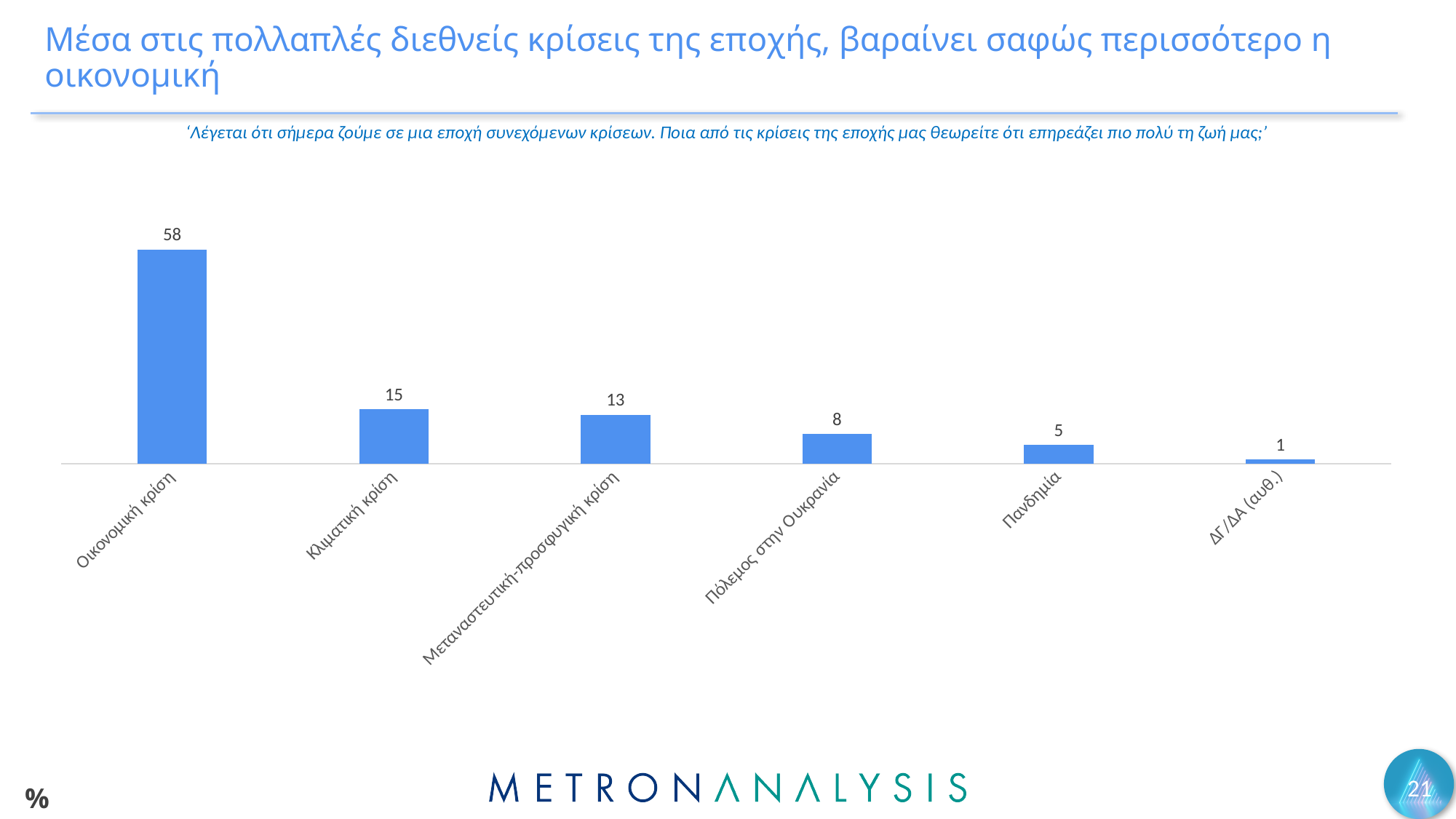
What is the value for Πανδημία? 5 What is the value for Κλιματική κρίση? 15 What kind of chart is shown on the slide? Bar chart Do the values rise or fall from left to right along the x axis? Fall What is the value for Οικονομική κρίση? 58 Which category has the lowest value? ΔΓ/ΔΑ (αυθ.) How many categories are shown in the chart? 6 What is the difference between the values for Οικονομική κρίση and Κλιματική κρίση? 43 What is the value for Μεταναστευτική-προσφυγική κρίση? 13 What is the value for Πόλεμος στην Ουκρανία? 8 Which is larger, the value for Πόλεμος στην Ουκρανία or the value for Πανδημία? Πόλεμος στην Ουκρανία Which category has the highest value? Οικονομική κρίση